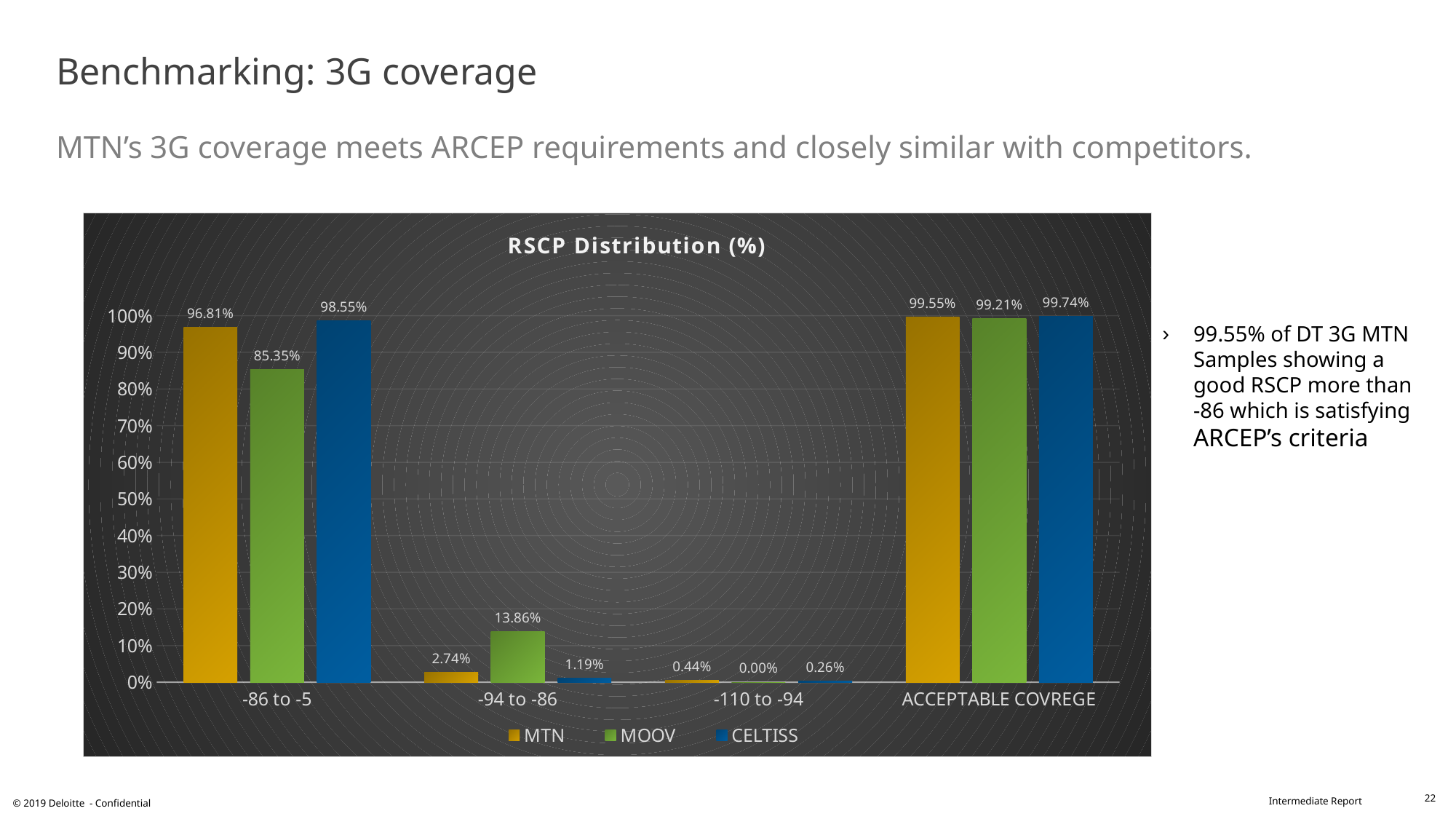
What is the value for CELTISS in the ACCEPTABLE COVREGE category? 99.74% Which series has the lowest value in the -94 to -86 category? CELTISS What is the value for MTN in the -86 to -5 category? 96.81% Which series has the highest value in the -86 to -5 category? CELTISS Which is larger in the ACCEPTABLE COVREGE category, MTN or MOOV? MTN What is the difference between the CELTISS and MOOV values in the -86 to -5 category? 13.20% What is the title of the chart? RSCP Distribution (%) What kind of chart is shown on the slide? Bar chart What is the value for MOOV in the -110 to -94 category? 0.00% How many categories are shown on the x axis? 4 How many series does the legend list? 3 What is the value for MOOV in the -94 to -86 category? 13.86%